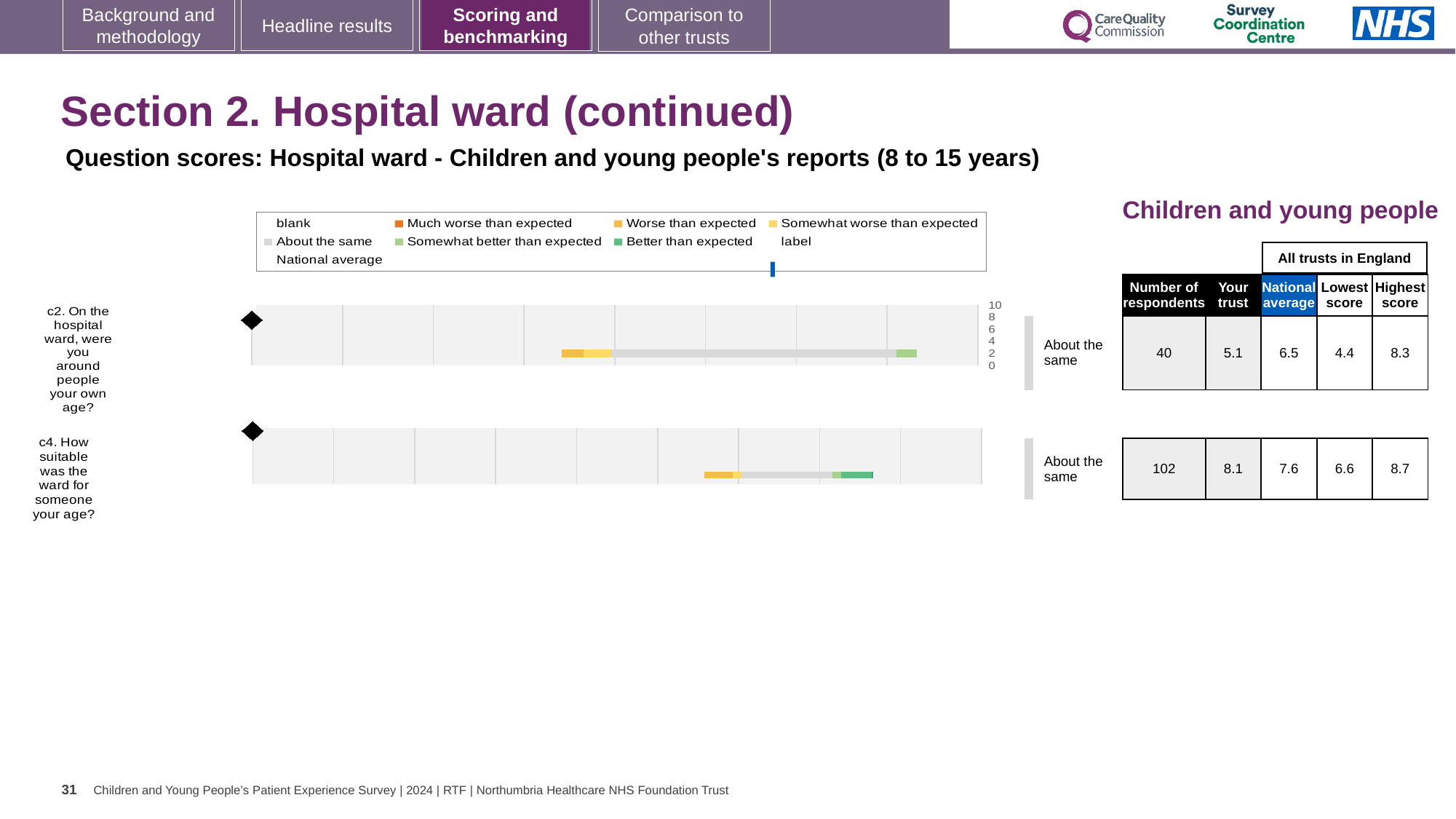
What kind of chart is used to show the question scores on this slide? bar chart What benchmark category is shown next to the chart for question c2? About the same What is the national average score for question c2? 6.5 What is the number of respondents for question c2 (On the hospital ward, were you around people your own age?)? 40 What is the lowest score among all trusts in England for question c2? 4.4 Which question has the higher 'Your trust' score, c2 or c4? c4 What is the highest score among all trusts in England for question c4? 8.7 By how much does the national average exceed the 'Your trust' score for question c2? 1.4 What is the difference between the highest score and the lowest score for question c4? 2.1 What is the 'Your trust' score for question c4 (How suitable was the ward for someone your age?)? 8.1 How many questions are plotted in the chart on this slide? 2 For question c2, which is larger: the 'Your trust' score or the national average? National average